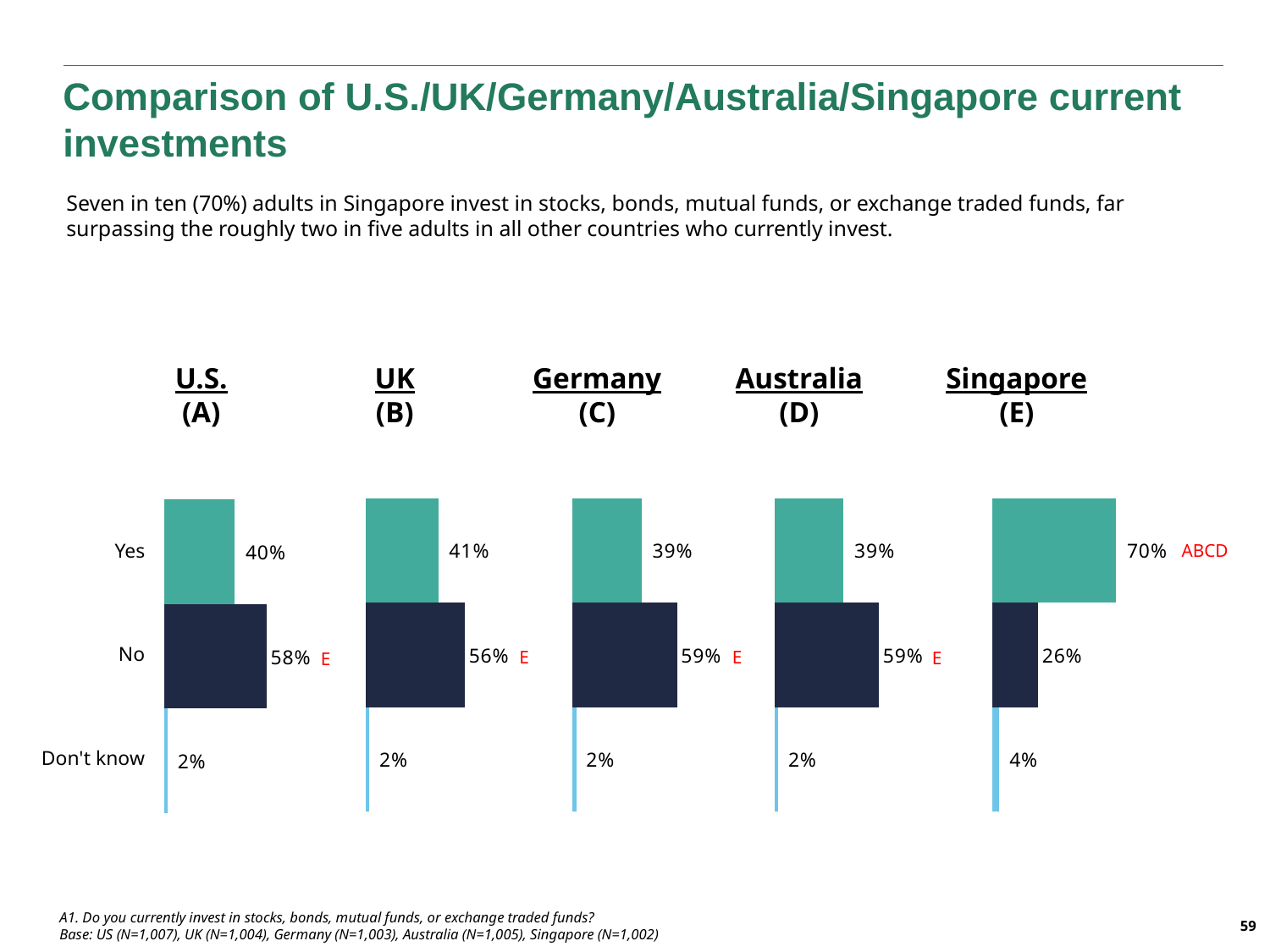
Across the five country charts, which country has the lowest "No" percentage? Singapore In the U.S. (A) chart, what percentage answered "No"? 58% How many response categories are shown in each country chart? 3 In the Singapore (E) chart, what percentage of adults answered "Yes"? 70% Across the five country charts, which country has the highest "Yes" percentage? Singapore Comparing the Germany (C) and UK (B) charts, which has the larger "No" percentage? Germany What type of chart is used to show the results for each country? Bar chart In the Singapore (E) chart, what is the difference between the "Yes" and "No" percentages? 44 percentage points In the Australia (D) chart, what percentage answered "Yes"? 39% In the UK (B) chart, what percentage answered "Yes"? 41% How many country charts are shown on the slide? 5 In the Singapore (E) chart, what percentage answered "Don't know"? 4%